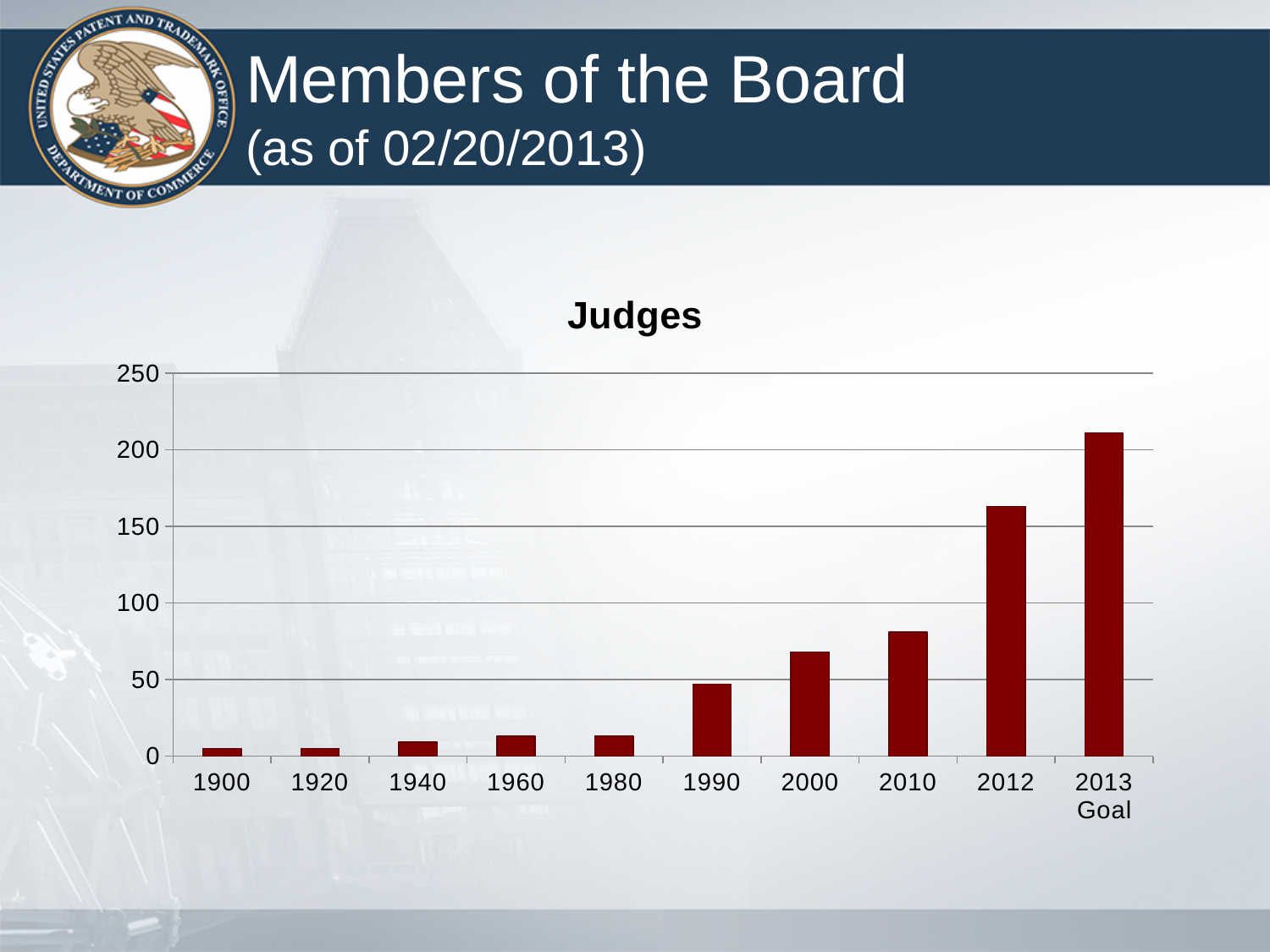
How many categories are shown on the x axis of the chart? 10 Which is larger, the value for 2010 or the value for 2012? 2012 Is the value for 2013 Goal greater or less than 200? greater Is the value for 2012 greater or less than 150? greater Is the value for 2000 greater or less than 50? greater What is the title of the chart? Judges What kind of chart is shown on the slide? bar chart Which category has the highest value in the chart? 2013 Goal What colour are the bars in the chart? dark red Do the values generally rise or fall from 1900 to 2013 Goal along the x axis? rise